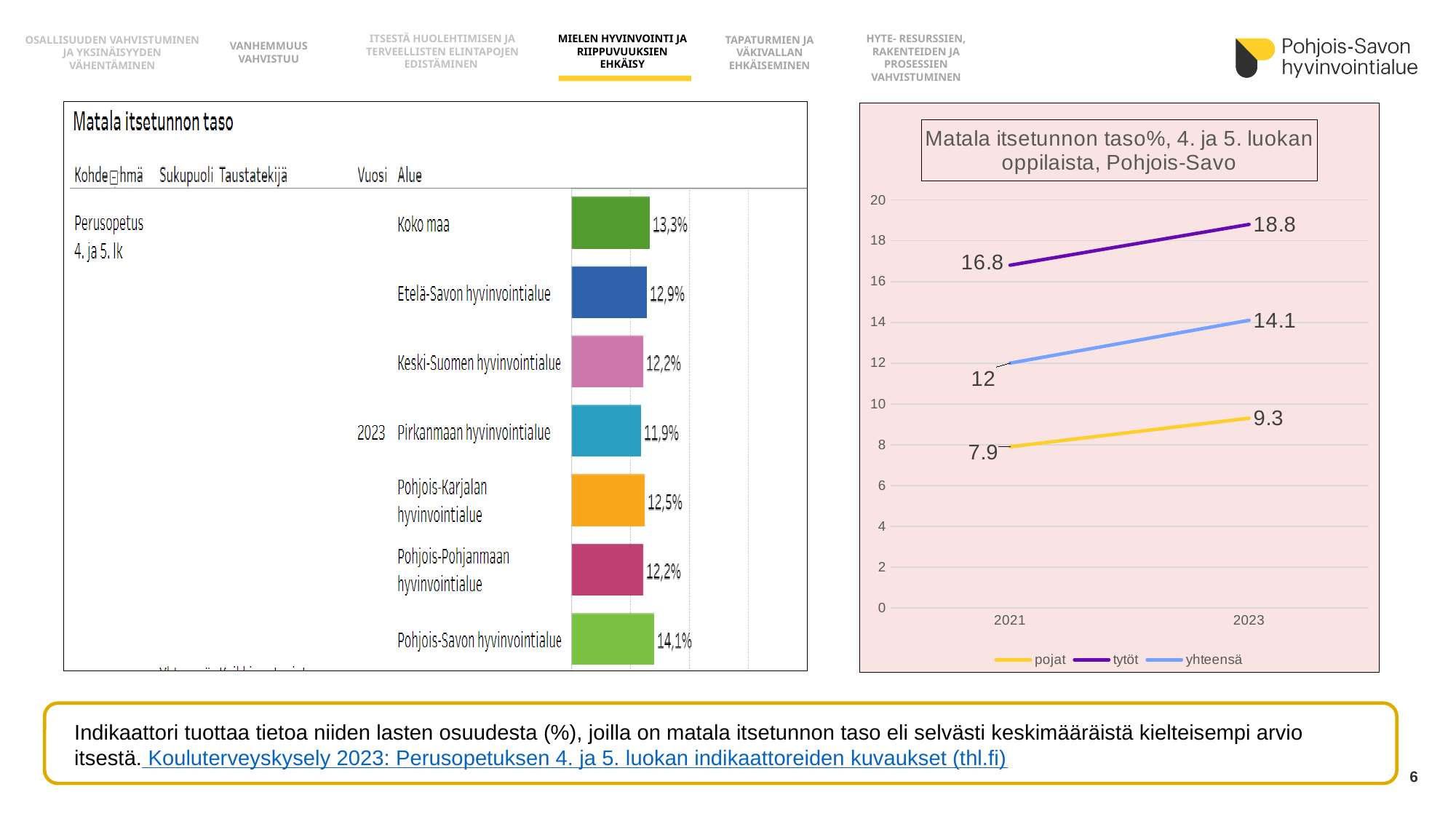
What kind of chart is the right chart 'Matala itsetunnon taso%, 4. ja 5. luokan oppilaista, Pohjois-Savo'? line chart In the right chart 'Matala itsetunnon taso%, 4. ja 5. luokan oppilaista, Pohjois-Savo', does the yhteensä series rise or fall from 2021 to 2023? rise In the right chart 'Matala itsetunnon taso%, 4. ja 5. luokan oppilaista, Pohjois-Savo', what is the value for tytöt in 2023? 18.8 In the left chart 'Matala itsetunnon taso', which region has the lowest value? Pirkanmaan hyvinvointialue In the left chart 'Matala itsetunnon taso', which is larger: Etelä-Savon hyvinvointialue or Pohjois-Karjalan hyvinvointialue? Etelä-Savon hyvinvointialue In the left chart 'Matala itsetunnon taso', what is the value for Koko maa? 13,3% In the left chart 'Matala itsetunnon taso', what is the value for Pohjois-Savon hyvinvointialue? 14,1% In the left chart 'Matala itsetunnon taso', what is the difference between Pohjois-Savon hyvinvointialue and Koko maa? 0,8 percentage points In the left chart 'Matala itsetunnon taso', how many regions are shown? 7 In the right chart 'Matala itsetunnon taso%, 4. ja 5. luokan oppilaista, Pohjois-Savo', how many series does the legend list? 3 In the right chart 'Matala itsetunnon taso%, 4. ja 5. luokan oppilaista, Pohjois-Savo', what is the value for pojat in 2021? 7.9 In the left chart 'Matala itsetunnon taso', which region has the highest value? Pohjois-Savon hyvinvointialue